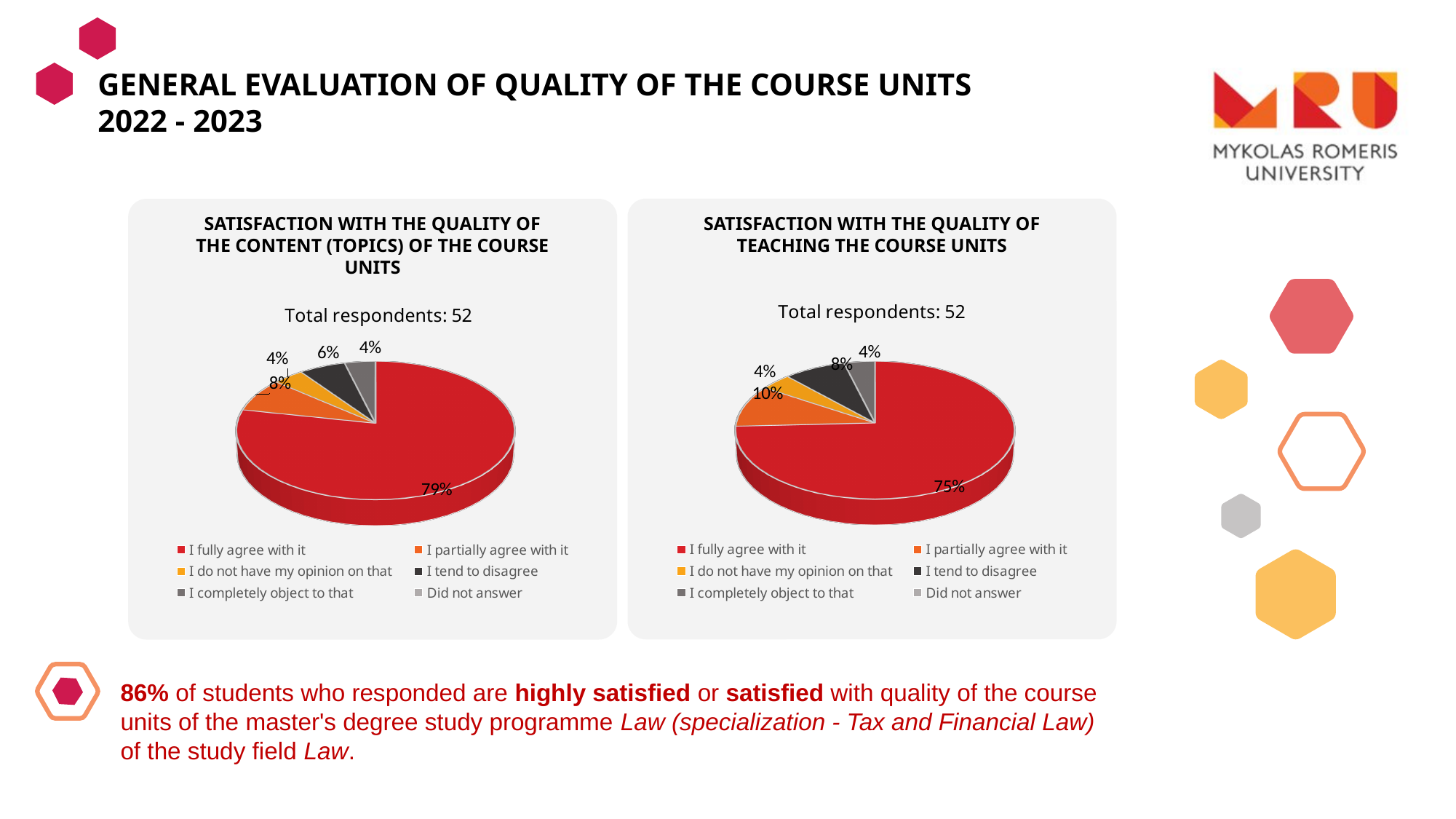
Which chart shows a larger share for 'I fully agree with it', the content chart or the teaching chart? The content chart In the right chart (teaching the course units), what share of respondents chose 'I partially agree with it'? 10% What type of chart is used in the 'Satisfaction with the quality of teaching the course units' panel? Pie chart How many total respondents are reported for the 'Satisfaction with the quality of teaching the course units' chart? 52 What is the difference between the 'I fully agree with it' shares in the content chart (79%) and the teaching chart (75%)? 4 percentage points In the chart titled 'Satisfaction with the quality of teaching the course units', what percentage of respondents chose 'I fully agree with it'? 75% In the right chart (teaching the course units), what percentage chose 'I tend to disagree'? 8% In the left chart (content of the course units), what share of respondents chose 'I partially agree with it'? 8% How many entries does the legend of the left chart (content of the course units) list? 6 In the left chart (content of the course units), what percentage chose 'I tend to disagree'? 6% In the chart titled 'Satisfaction with the quality of the content (topics) of the course units', what percentage of respondents chose 'I fully agree with it'? 79% In the left chart (content of the course units), which response category has the largest share? I fully agree with it